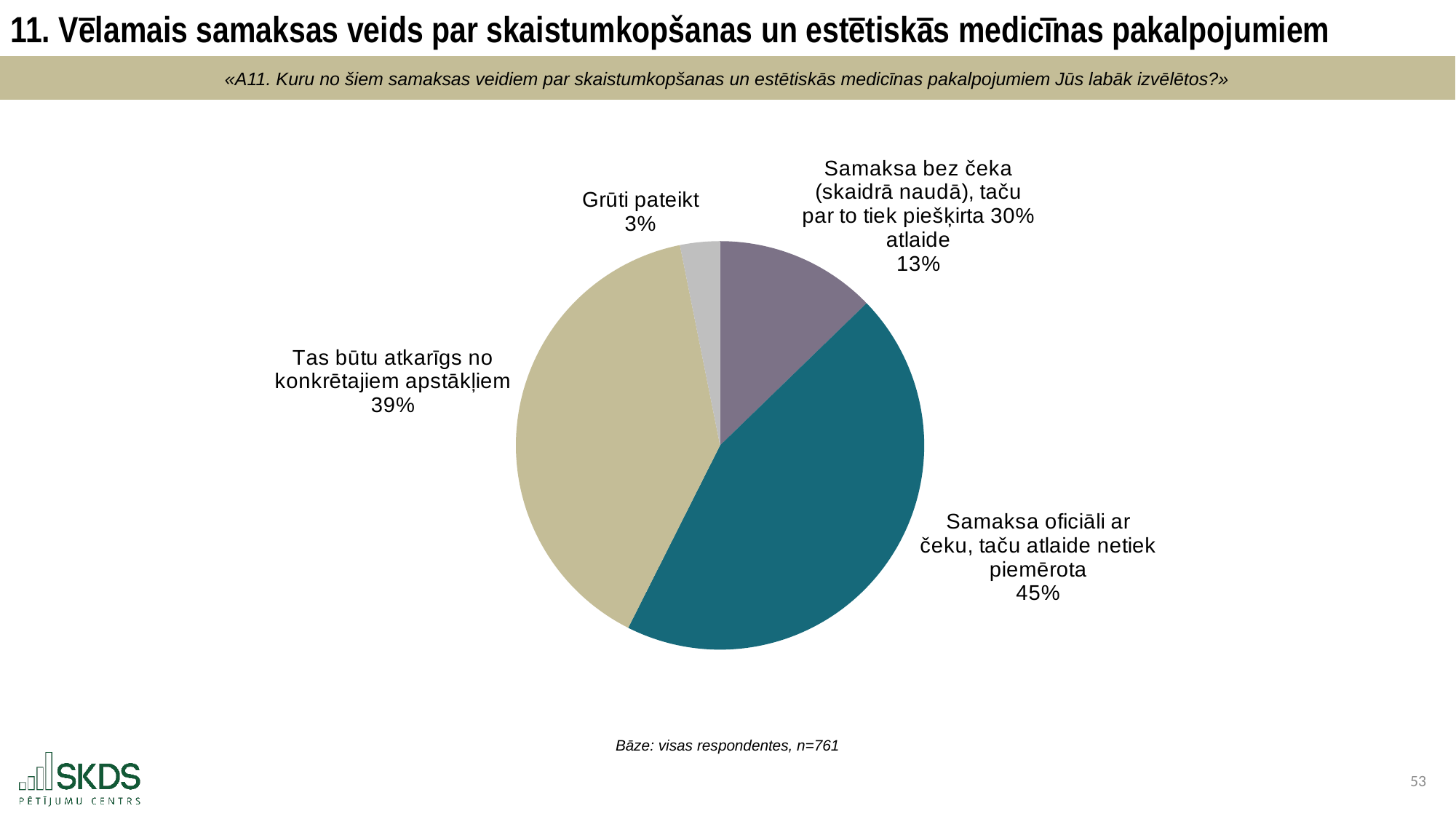
What is the difference in percentage points between "Samaksa oficiāli ar čeku, taču atlaide netiek piemērota" and "Tas būtu atkarīgs no konkrētajiem apstākļiem"? 6 percentage points What is the base (number of respondents) stated below the chart? n=761 What share of respondents answered "Grūti pateikt"? 3% What kind of chart is shown on the slide? Pie chart What share of respondents chose "Tas būtu atkarīgs no konkrētajiem apstākļiem"? 39% What share of respondents chose "Samaksa oficiāli ar čeku, taču atlaide netiek piemērota"? 45% Which category has the largest slice of the pie? Samaksa oficiāli ar čeku, taču atlaide netiek piemērota How many slices does the pie chart have? 4 Which is larger: the share for "Samaksa bez čeka (skaidrā naudā), taču par to tiek piešķirta 30% atlaide" or the share for "Grūti pateikt"? Samaksa bez čeka (skaidrā naudā), taču par to tiek piešķirta 30% atlaide What colour is the slice for "Samaksa oficiāli ar čeku, taču atlaide netiek piemērota"? Teal Which category has the smallest slice of the pie? Grūti pateikt What share of respondents chose "Samaksa bez čeka (skaidrā naudā), taču par to tiek piešķirta 30% atlaide"? 13%